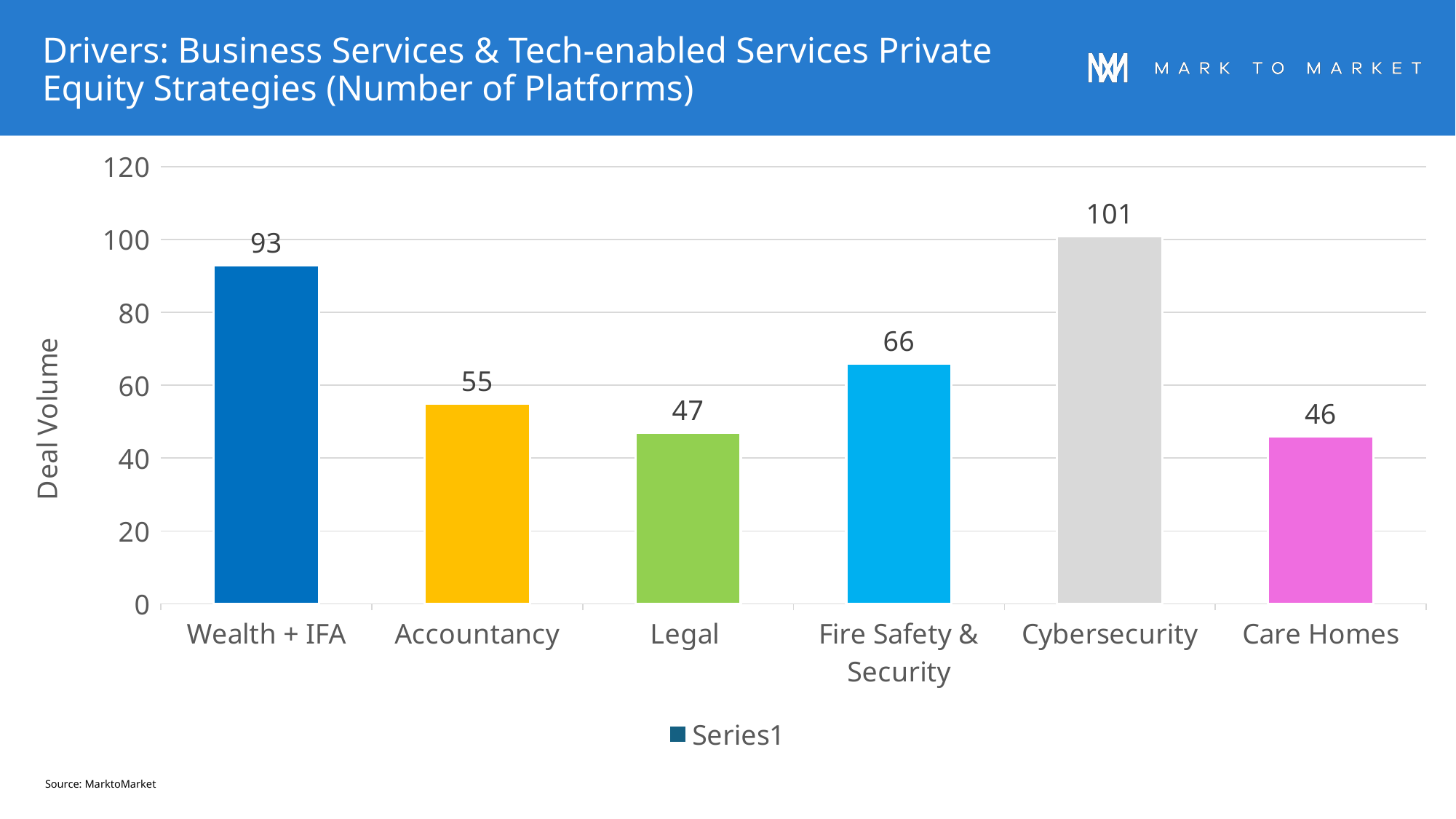
How many categories are shown on the x axis? 6 What is the difference in deal volume between Accountancy and Legal? 8 What is the deal volume for Wealth + IFA? 93 What is the difference in deal volume between Cybersecurity and Wealth + IFA? 8 Which category has the lowest deal volume? Care Homes What is the deal volume for Fire Safety & Security? 66 What kind of chart is shown on the slide? Bar chart Is the deal volume for Legal greater or less than 60? less Which category has the highest deal volume? Cybersecurity What is the deal volume for Cybersecurity? 101 What is the label on the vertical axis? Deal Volume Which has a higher deal volume, Accountancy or Fire Safety & Security? Fire Safety & Security